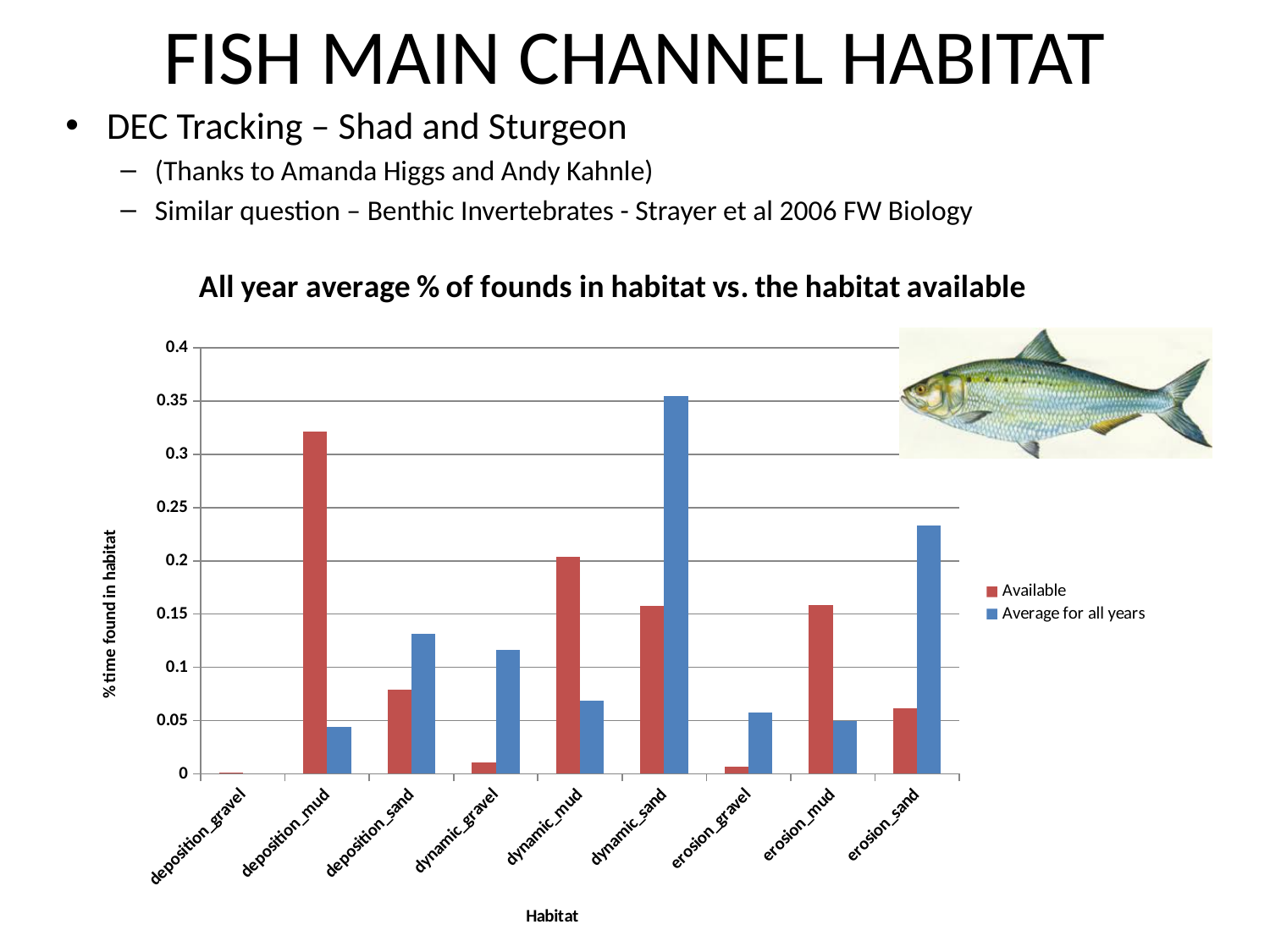
What is the title of the chart? All year average % of founds in habitat vs. the habitat available How many habitat categories are shown along the x axis? 9 How many series does the legend list? 2 Is the Average for all years value for erosion_sand greater or less than 0.25? less Which habitat has the highest Average for all years value? dynamic_sand For dynamic_mud, which is larger: Available or Average for all years? Available Is the Available value for deposition_mud greater or less than 0.3? greater What kind of chart is shown on the slide? bar chart Which colour represents the Available series? red For dynamic_gravel, which is larger: Available or Average for all years? Average for all years Which habitat has the highest Available value? deposition_mud